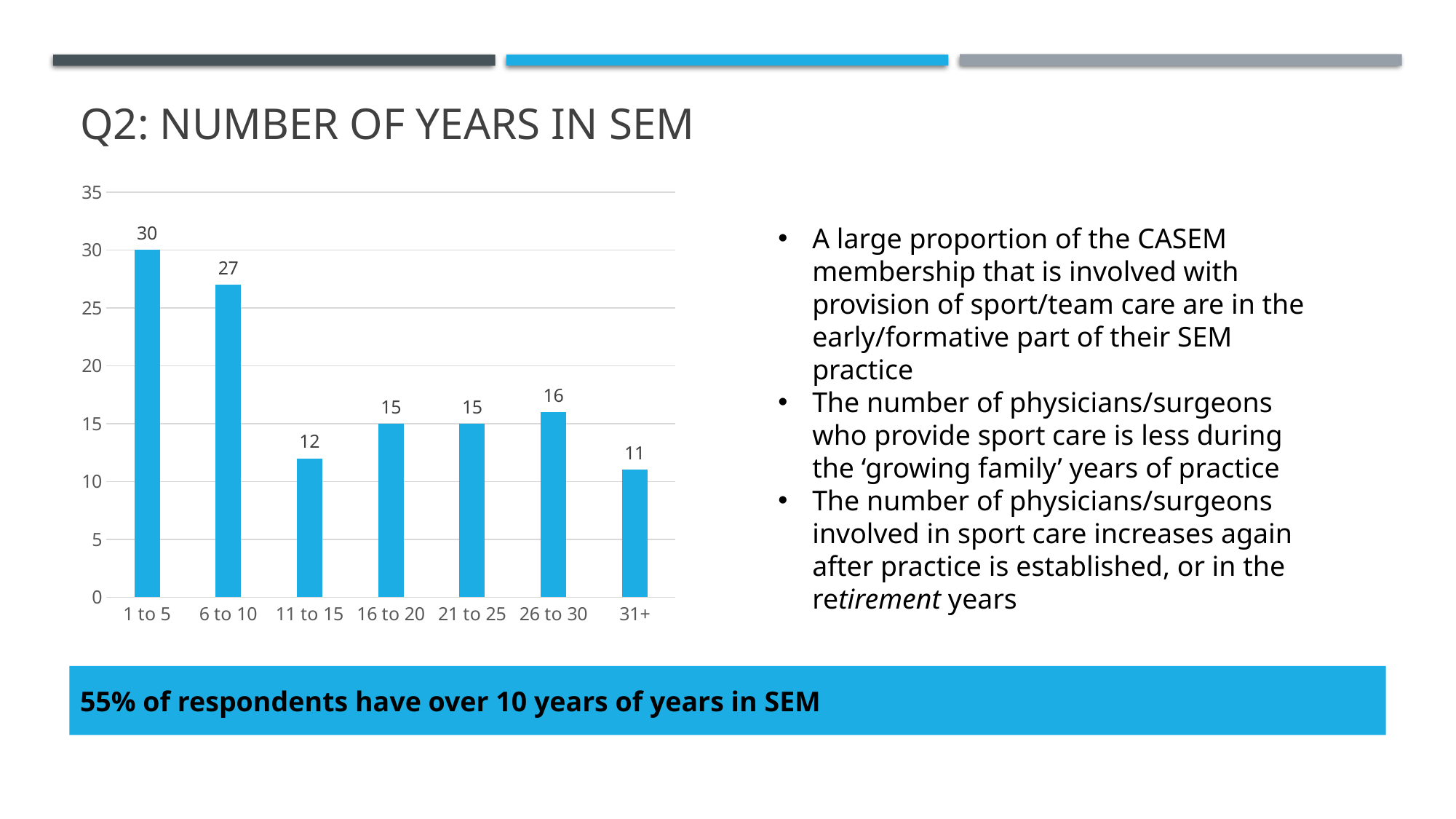
What is the value for the 11 to 15 years category? 12 Which is larger, the value for 6 to 10 or the value for 26 to 30? 6 to 10 What is the difference between the values for 26 to 30 and 31+? 5 Which category has the lowest value? 31+ Which category has the highest value? 1 to 5 What is the difference between the values for 1 to 5 and 6 to 10? 3 What is the value for the 31+ years category? 11 What is the title of the slide containing the chart? Q2: NUMBER OF YEARS IN SEM How many categories are shown on the x axis? 7 Is the value for 16 to 20 greater or less than 20? less What is the value for the 1 to 5 years category? 30 What kind of chart is shown on the slide? bar chart